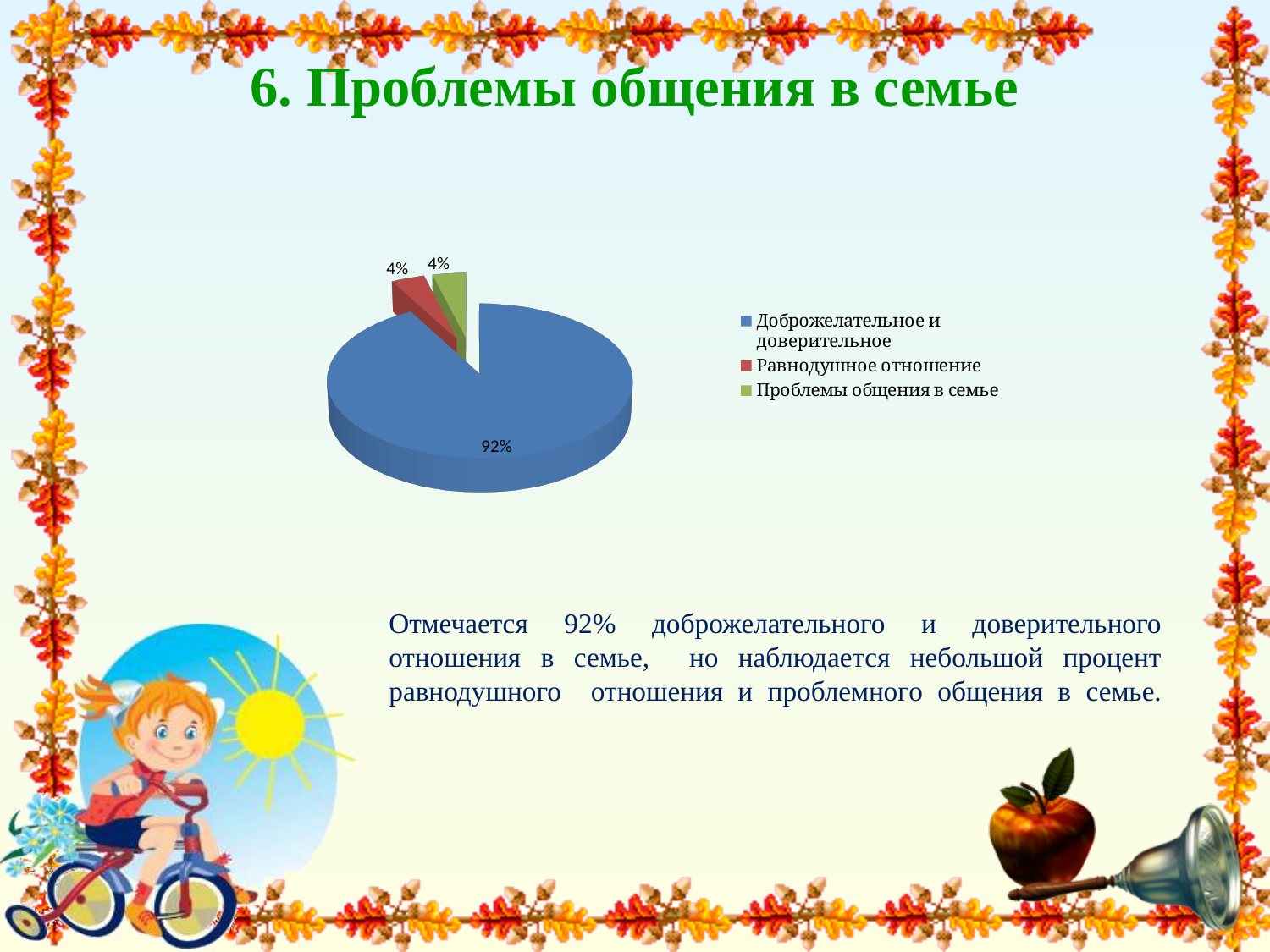
What percentage does the slice "Проблемы общения в семье" represent? 4% What colour is the slice for "Равнодушное отношение"? red How many slices does the pie chart have? 3 What colour is the largest slice of the pie? blue What share of the pie do the two smaller slices make up together? 8% What is the difference between the share for "Доброжелательное и доверительное" and the share for "Равнодушное отношение"? 88% What percentage does the slice "Доброжелательное и доверительное" represent? 92% What kind of chart is shown on the slide? pie chart Which is larger: the slice for "Доброжелательное и доверительное" or the slice for "Проблемы общения в семье"? Доброжелательное и доверительное What percentage does the slice "Равнодушное отношение" represent? 4% Which category has the largest slice of the pie? Доброжелательное и доверительное How many entries does the legend list? 3